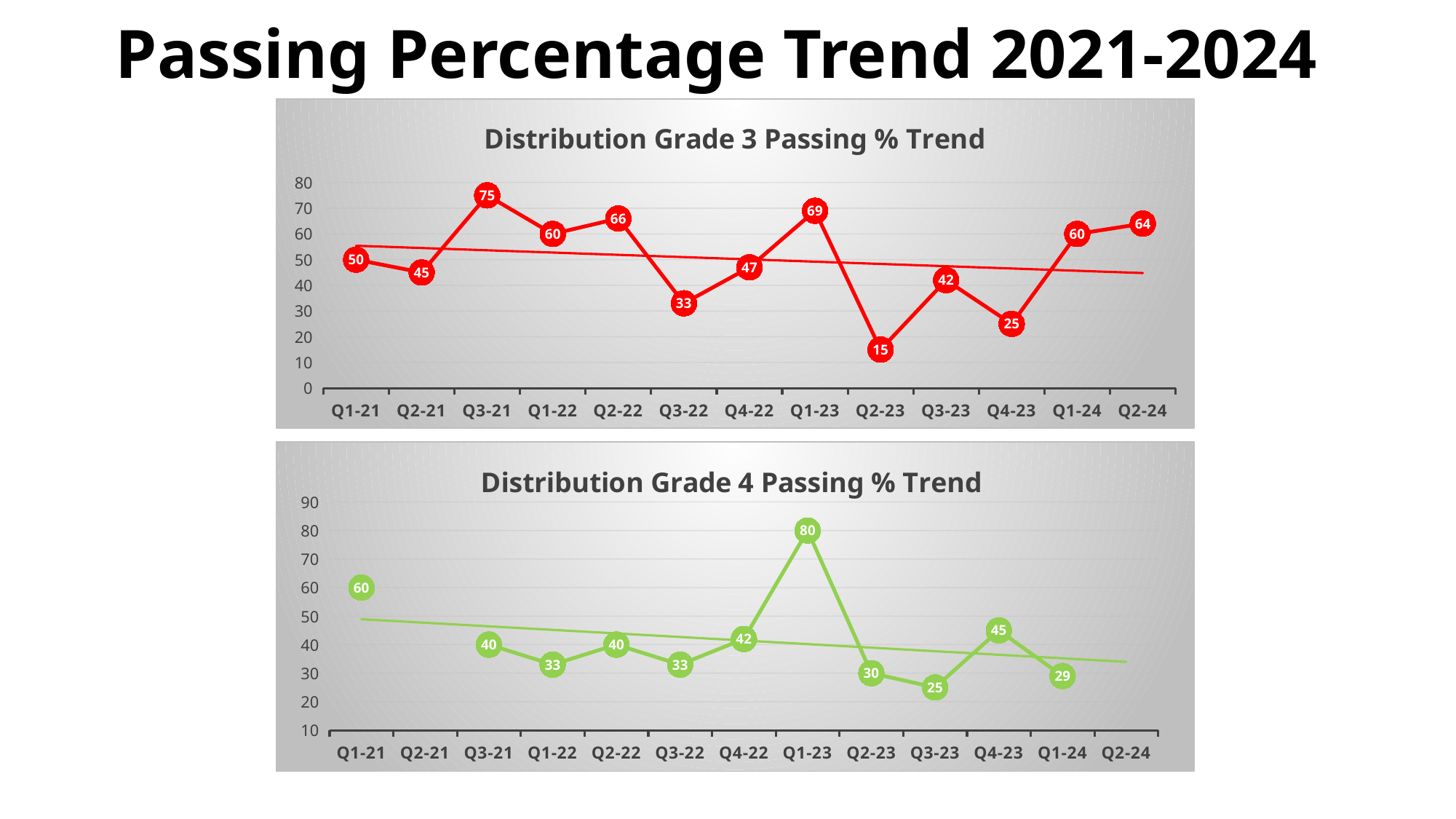
In the Distribution Grade 3 Passing % Trend chart, what is the value for Q3-21? 75 In the Distribution Grade 3 Passing % Trend chart, what is the difference between the values for Q1-23 and Q2-23? 54 What colour is the line in the Distribution Grade 3 Passing % Trend chart? Red In the Distribution Grade 4 Passing % Trend chart, what is the difference between the values for Q1-21 and Q1-24? 31 In the Distribution Grade 3 Passing % Trend chart, how many quarters are shown on the x axis? 13 In the Distribution Grade 4 Passing % Trend chart, what is the value for Q1-23? 80 In the Distribution Grade 3 Passing % Trend chart, which quarter has the lowest value? Q2-23 In the Distribution Grade 4 Passing % Trend chart, which quarter has the lowest plotted value? Q3-23 What kind of chart is the Distribution Grade 4 Passing % Trend chart? Line chart In the Distribution Grade 3 Passing % Trend chart, which quarter has the highest value? Q3-21 In the Distribution Grade 4 Passing % Trend chart, what is the value for Q4-23? 45 In the Distribution Grade 3 Passing % Trend chart, which is larger, the value for Q2-22 or the value for Q4-22? Q2-22